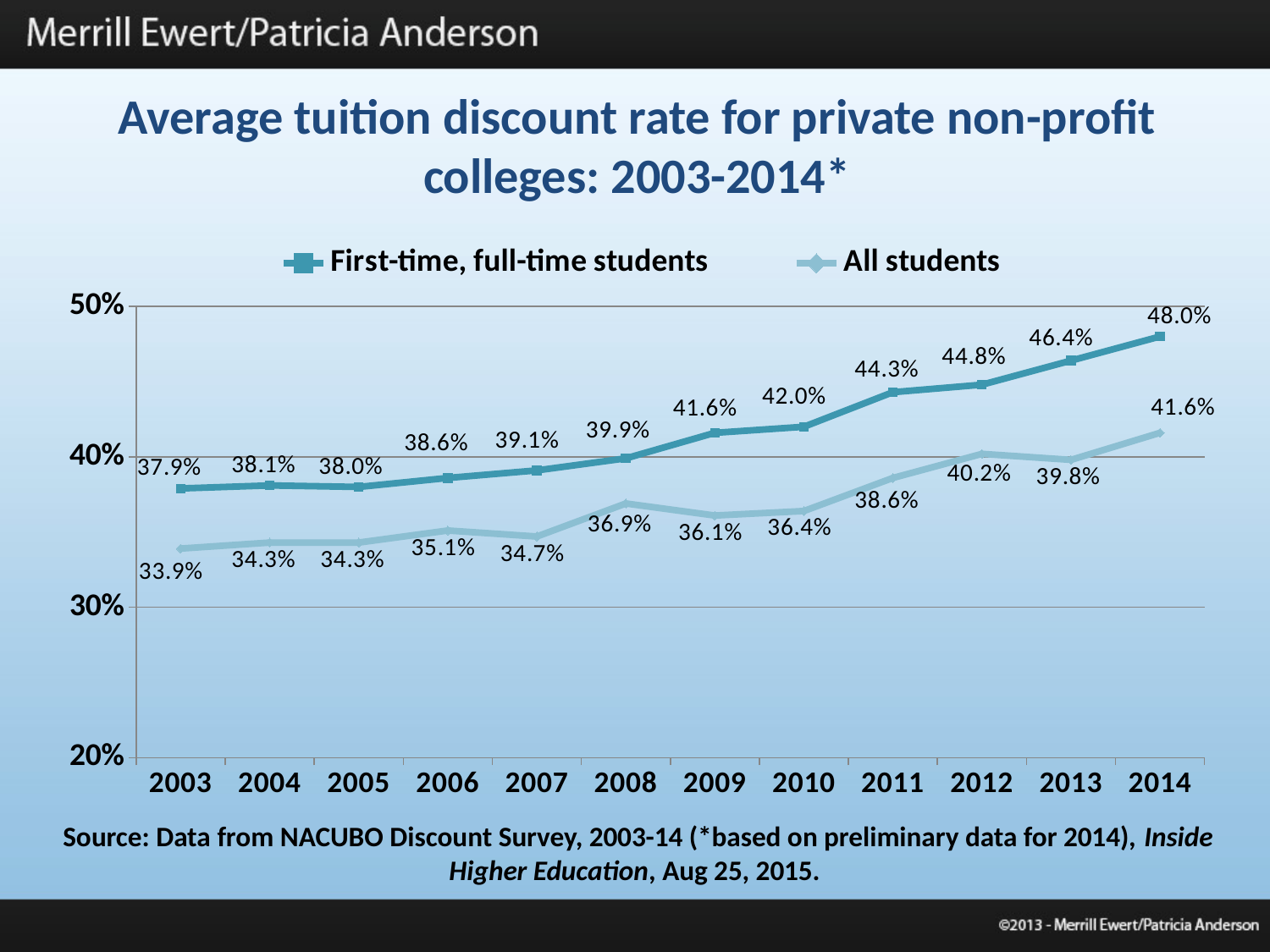
How many years are shown on the x axis? 12 What is the difference between the first-time, full-time students rate and the all students rate in 2014? 6.4% In which year is the first-time, full-time students rate highest? 2014 What is the average tuition discount rate for all students in 2003? 33.9% What is the value for all students in 2012? 40.2% What kind of chart is shown on the slide? Line chart How many series does the legend list? 2 Is the value for all students in 2013 greater or less than 40%? less Which is larger in 2008: the first-time, full-time students rate or the all students rate? First-time, full-time students What is the average tuition discount rate for first-time, full-time students in 2014? 48.0% Does the first-time, full-time students rate generally rise or fall from 2003 to 2014? Rise In which year is the all students rate lowest? 2003